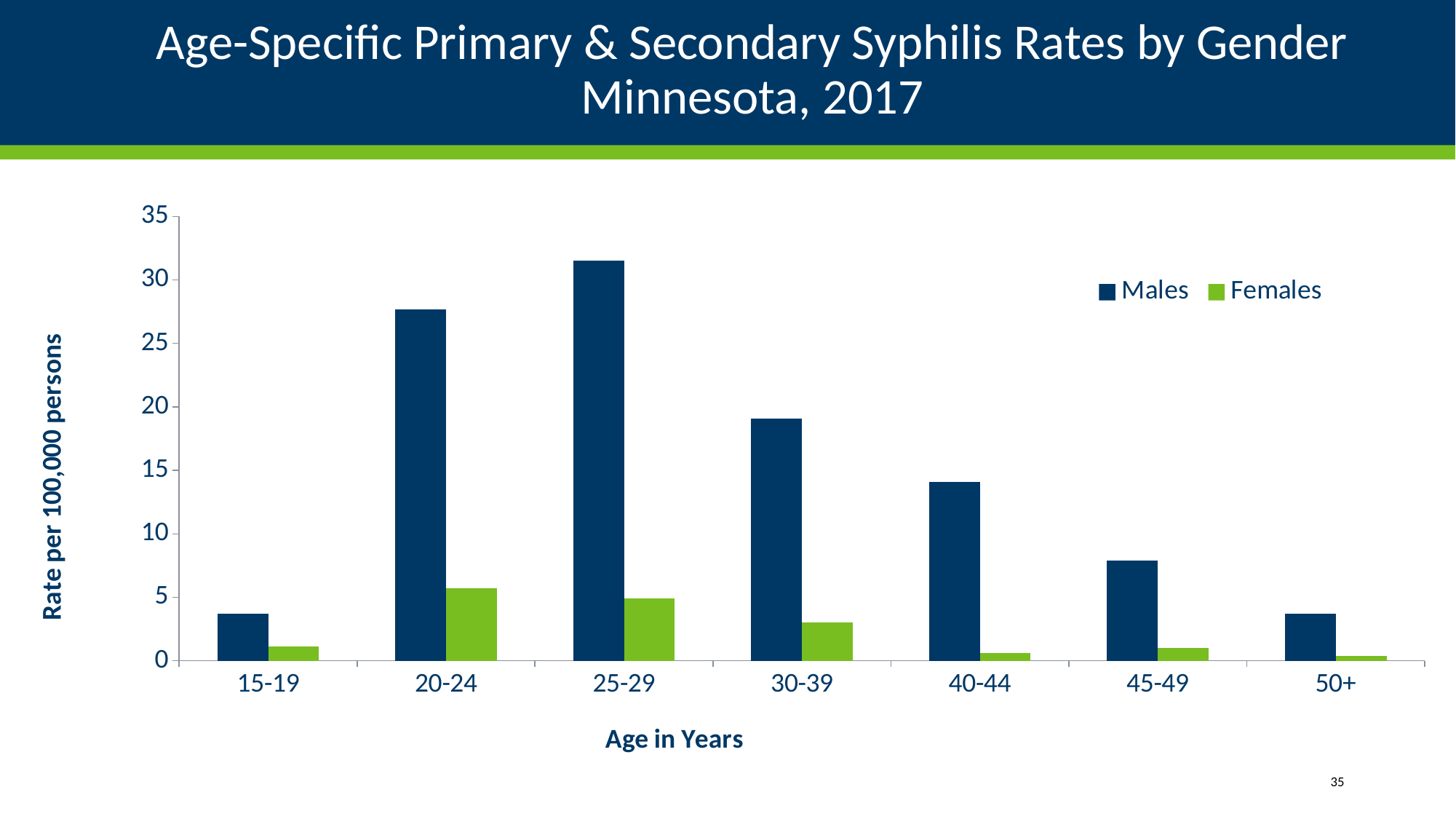
Is the Males rate for the 25-29 age group greater or less than 30? greater Which is larger, the Males rate for 30-39 or the Males rate for 40-44? 30-39 Is the Males rate for the 20-24 age group greater or less than 25? greater Which age group has the highest rate for Females? 20-24 What is the label of the y axis? Rate per 100,000 persons How many age groups are shown on the x axis? 7 Is the Males rate for the 45-49 age group greater or less than 10? less How many series does the legend list? 2 Which age group has the highest rate for Males? 25-29 What kind of chart is shown on the slide? Bar chart Do the Males rates rise or fall across the age groups from 25-29 to 50+? fall